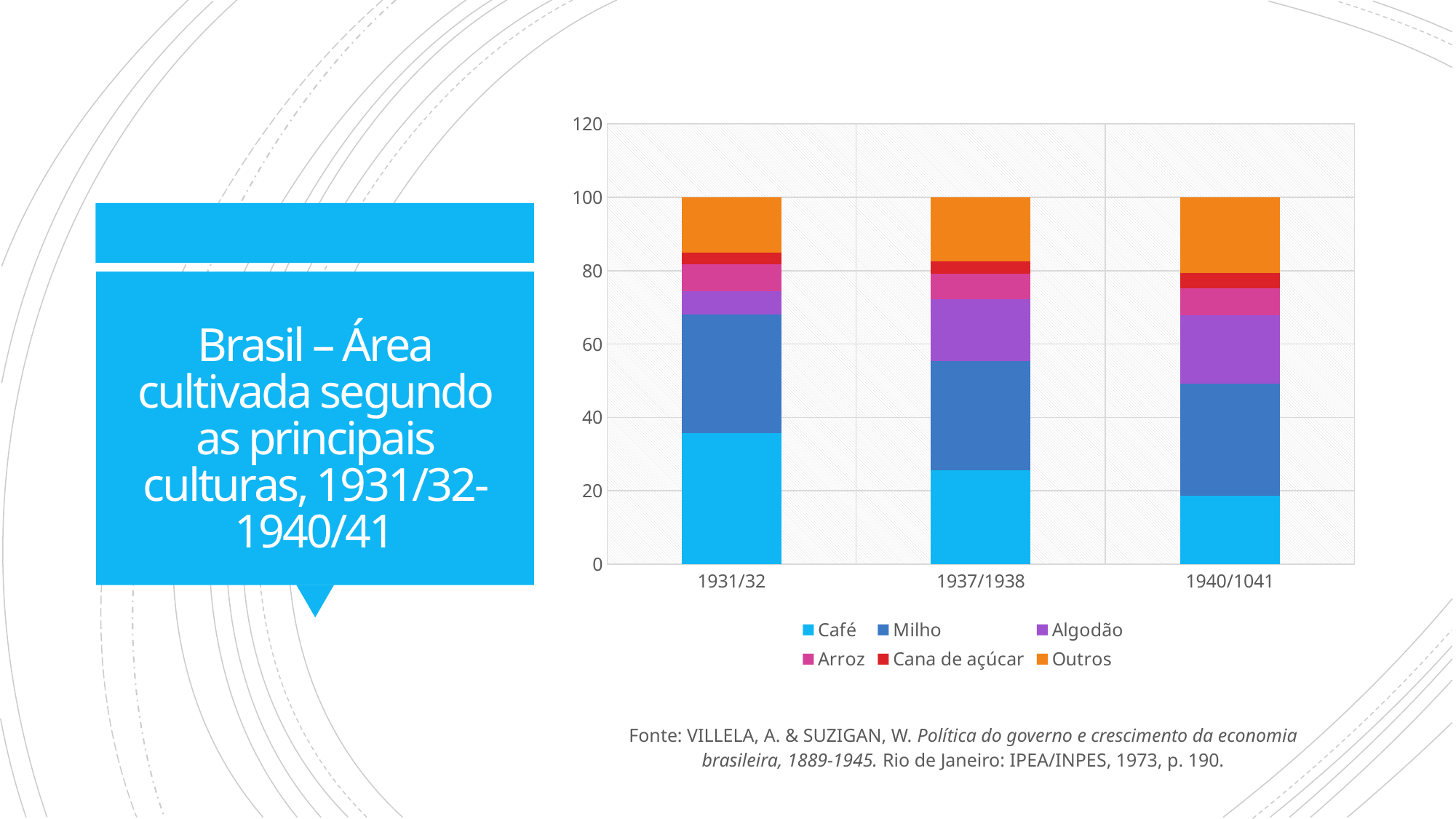
Which series is shown in orange in the chart's legend? Outros Does the Café segment rise or fall from 1931/32 to 1940/1041? Fall Is the Café value for 1931/32 greater or less than 20? greater Is the Café value for 1940/1041 greater or less than 40? less In which period is the Café segment the smallest? 1940/1041 What kind of chart is shown on the slide? Stacked bar chart What is the total height of the stacked bar for 1931/32? 100 In which period is the Café segment the largest? 1931/32 What is the total height of the stacked bar for 1940/1041? 100 How many series does the chart's legend list? 6 How many periods (categories) are shown on the x axis of the chart? 3 Which is larger, the Café segment for 1931/32 or for 1937/1938? 1931/32